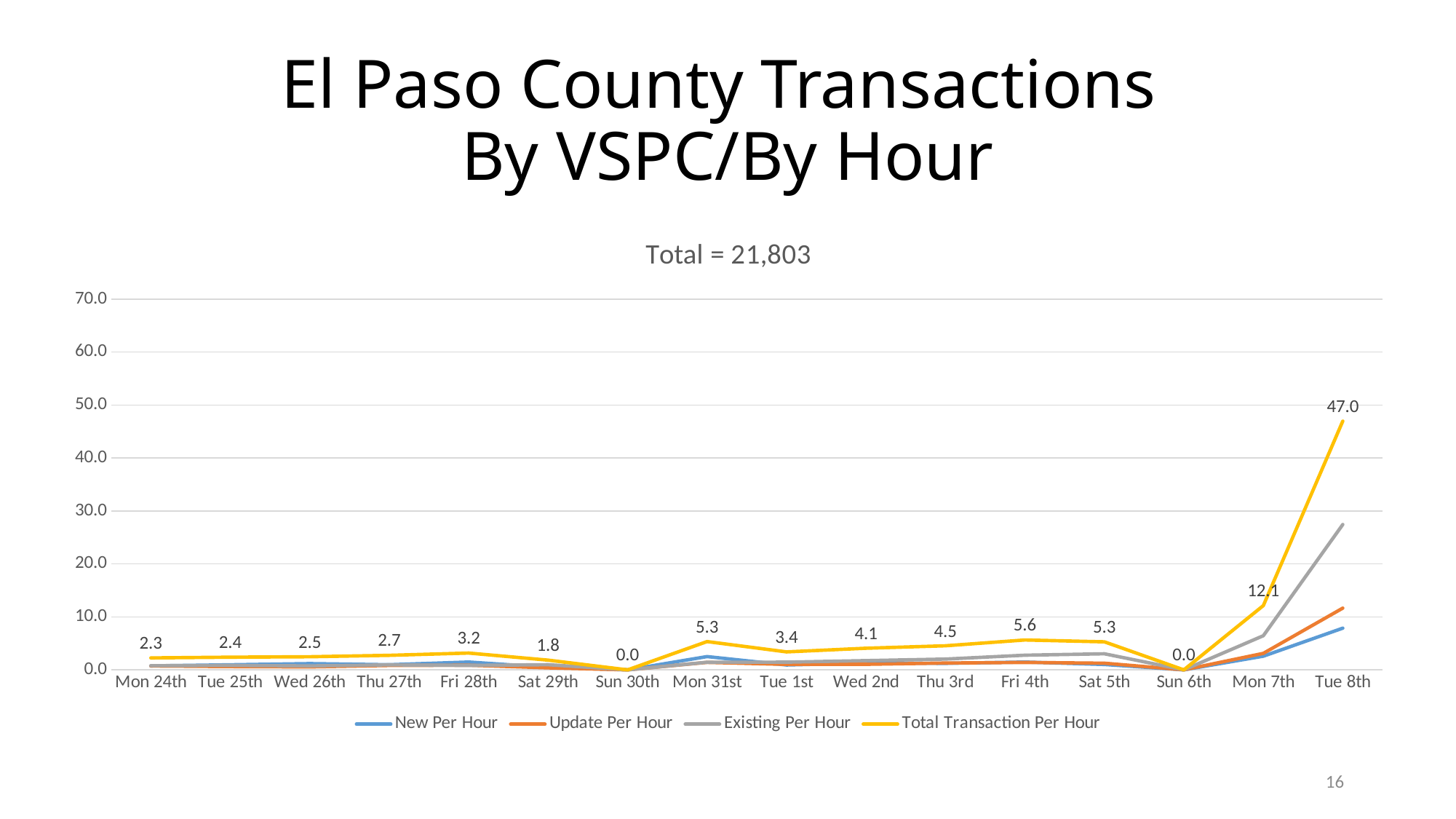
What is the difference in Total Transaction Per Hour between Tue 8th and Mon 7th? 34.9 On which date is Total Transaction Per Hour highest? Tue 8th What is the Total Transaction Per Hour value for Fri 4th? 5.6 What is the Total Transaction Per Hour value for Mon 7th? 12.1 What type of chart is shown on the slide? line chart How many dates are shown along the x axis? 16 Which series is drawn in yellow? Total Transaction Per Hour Which is larger, the Total Transaction Per Hour for Mon 31st or for Tue 1st? Mon 31st How many series does the legend list? 4 Is the Existing Per Hour value for Tue 8th greater or less than 20.0? greater What is the Total Transaction Per Hour value for Tue 8th? 47.0 What is the chart's title? Total = 21,803